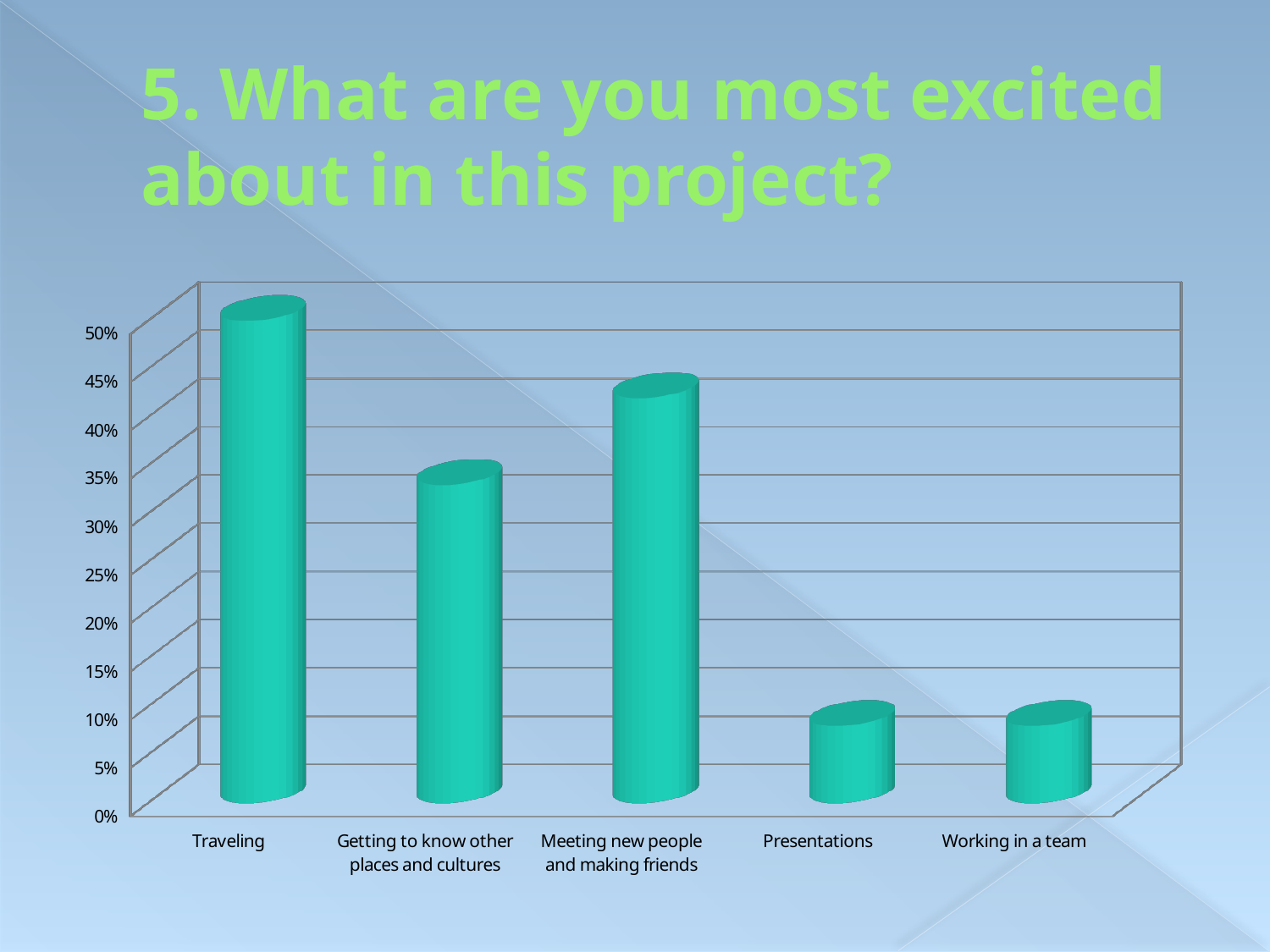
Is the value for Getting to know other places and cultures greater or less than 40%? less Is the value for Traveling greater or less than 45%? greater Which is larger, the value for Traveling or the value for Meeting new people and making friends? Traveling Is the value for Presentations greater or less than 15%? less Which is larger, the value for Getting to know other places and cultures or the value for Meeting new people and making friends? Meeting new people and making friends How many categories are shown on the x axis of the chart? 5 What is the title of the slide containing the chart? 5. What are you most excited about in this project? What kind of chart is shown on the slide? bar chart What colour are the bars in the chart? teal Which category has the highest value in the chart? Traveling